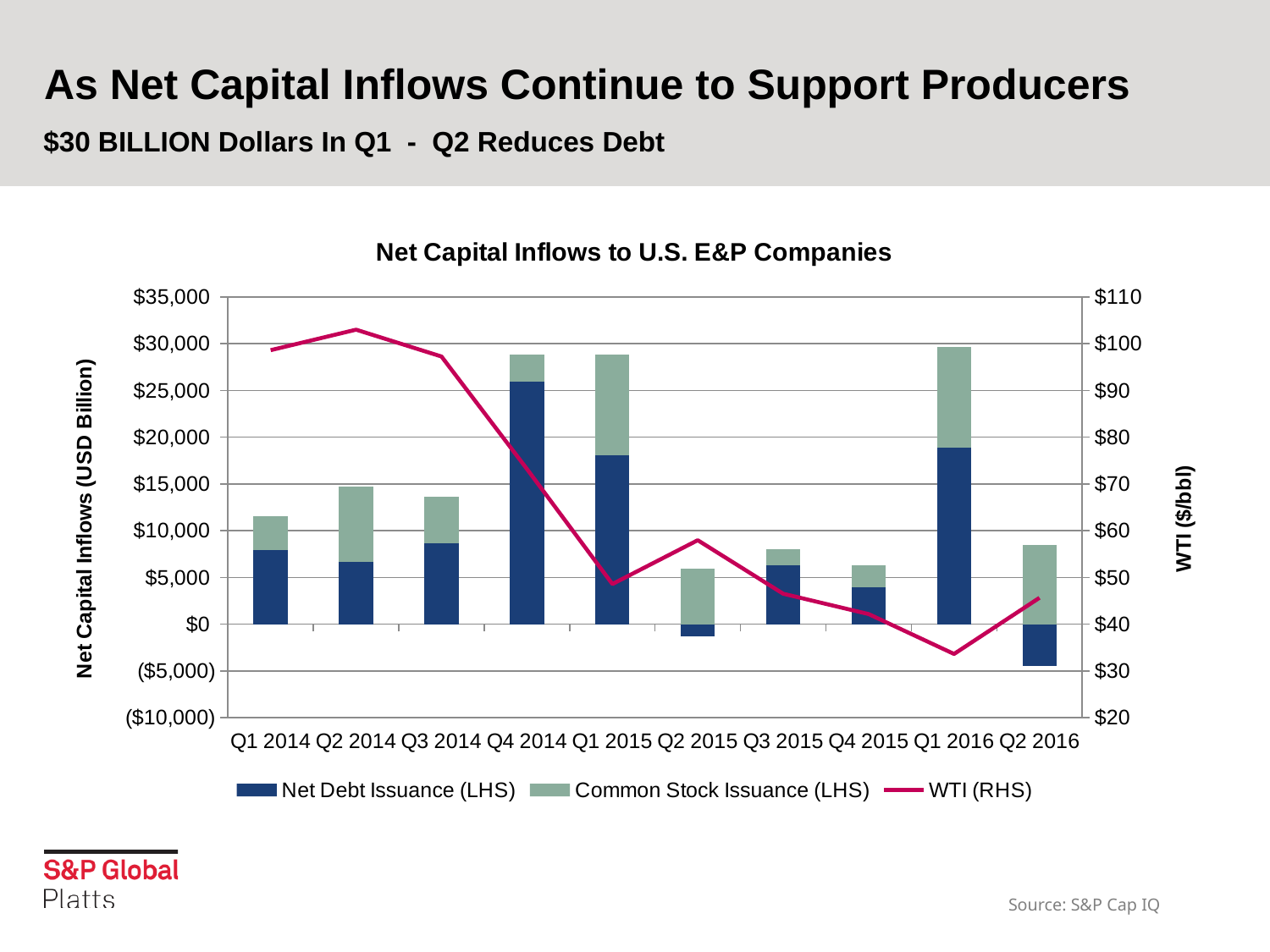
In which quarter is WTI at its highest? Q2 2014 Is the WTI value for Q1 2014 greater or less than $90? greater In which quarter is Net Debt Issuance the lowest? Q2 2016 How many quarters are shown on the x axis? 10 Is the Net Debt Issuance value for Q2 2015 greater or less than $0? less In which quarter is WTI at its lowest? Q1 2016 What kind of chart is shown on the slide? A bar chart with a line In which quarter is Net Debt Issuance the highest? Q4 2014 Which quarter has the larger Net Debt Issuance, Q1 2015 or Q3 2015? Q1 2015 Does WTI rise or fall from Q1 2014 to Q1 2016? fall How many series does the legend list? 3 Is the Net Debt Issuance value for Q4 2014 greater or less than $20,000? greater